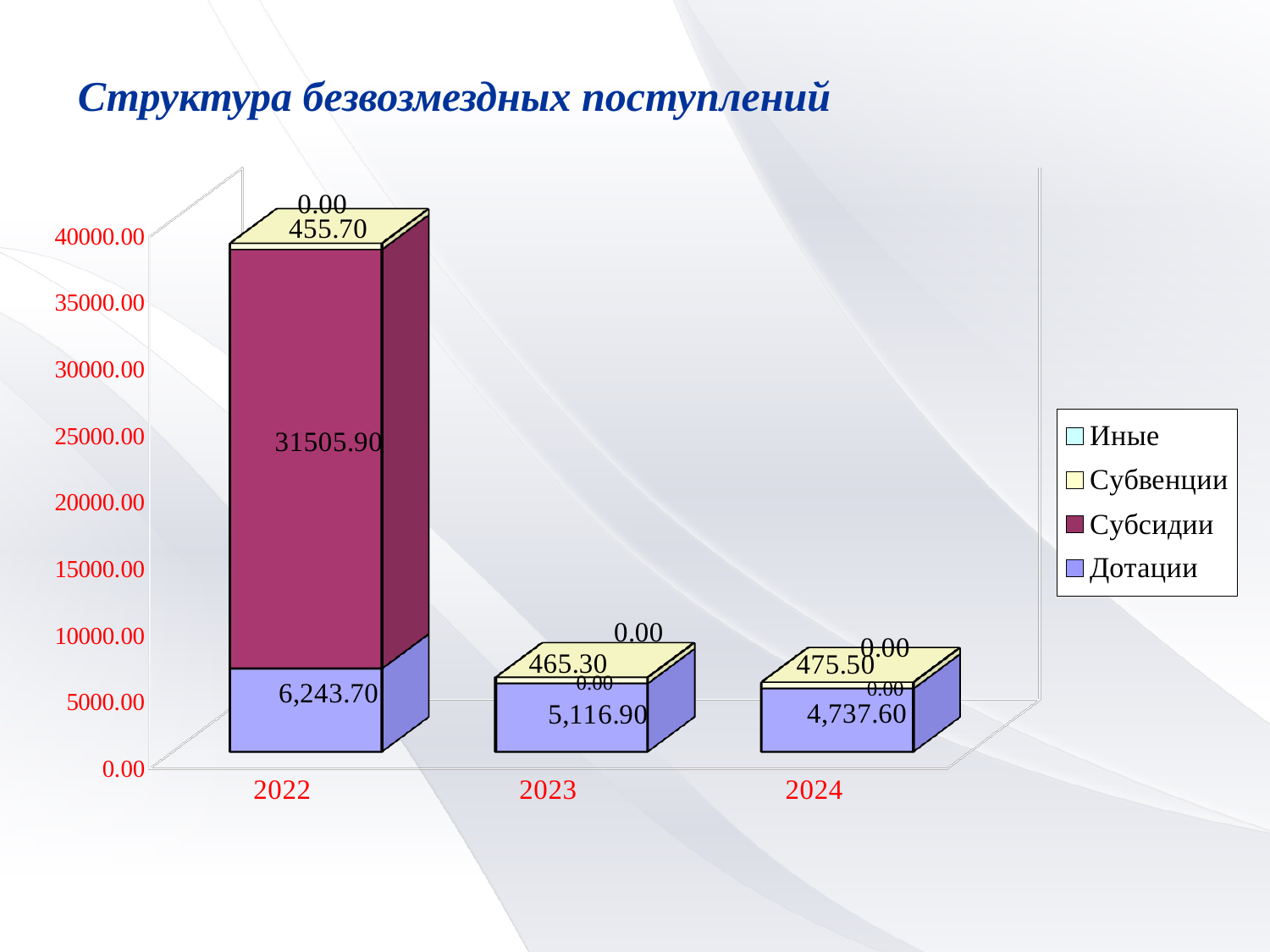
How many years are shown on the x axis? 3 What is the value of Дотации for 2023? 5,116.90 What is the value of Дотации for 2024? 4,737.60 Which is larger: Субвенции in 2023 or Субвенции in 2024? 2024 Which year has the highest value for Дотации? 2022 What is the value of Субсидии for 2022? 31505.90 What is the difference between the Дотации values for 2022 and 2023? 1,126.80 What is the total of the stacked bar for 2023? 5,582.20 What kind of chart is shown on the slide? Stacked bar chart Which year has the lowest value for Субвенции? 2022 How many series does the legend list? 4 What is the value of Субвенции for 2024? 475.50